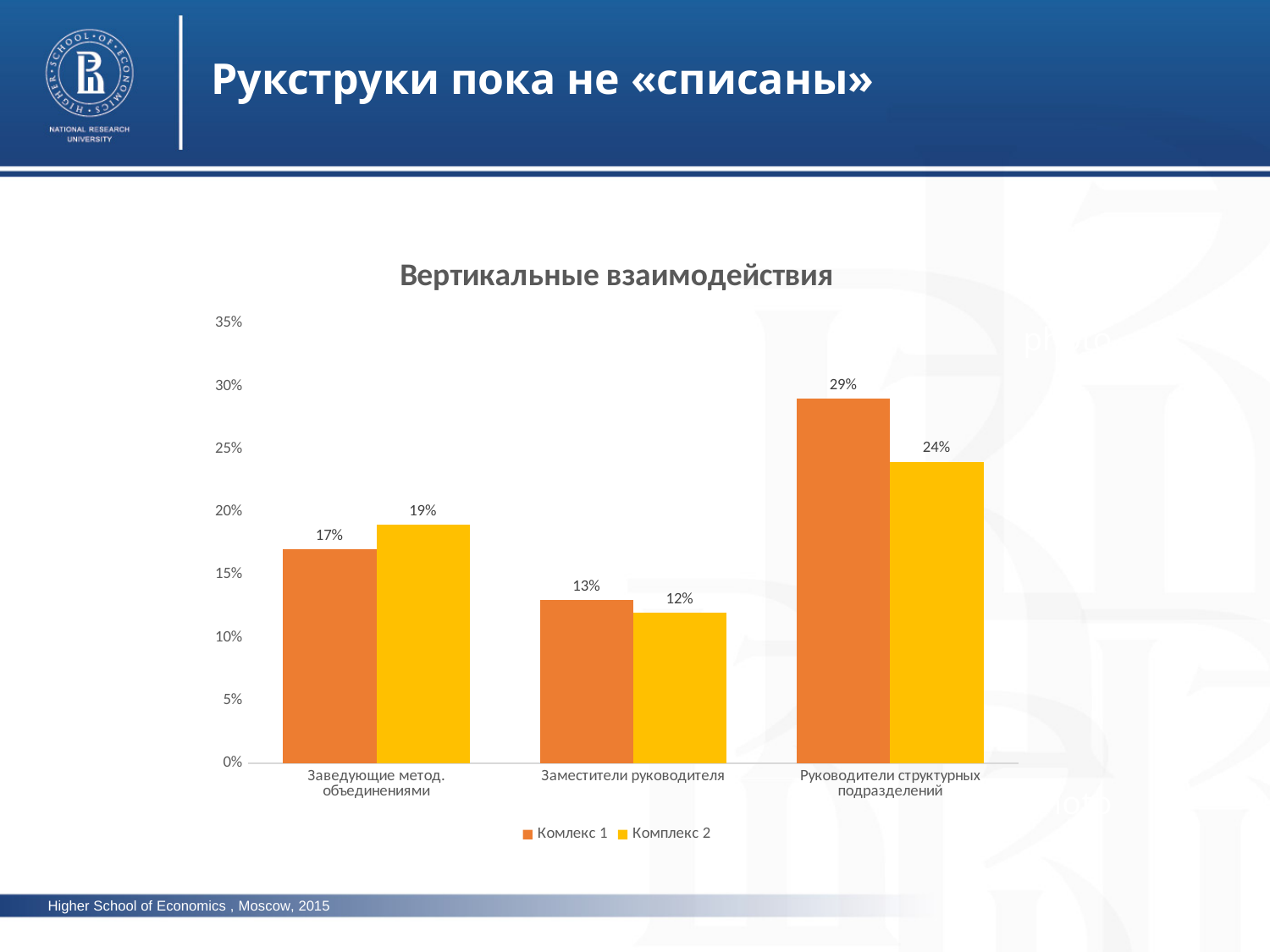
Which category has the highest value for Комлекс 1? Руководители структурных подразделений How many categories are shown on the x axis? 3 What is the value for Комлекс 1 for Заведующие метод. объединениями? 17% How many series does the legend list? 2 Is the value for Комлекс 1 for Руководители структурных подразделений greater or less than 25%? greater What is the value for Комплекс 2 for Заместители руководителя? 12% Which is larger for Заведующие метод. объединениями: Комлекс 1 or Комплекс 2? Комплекс 2 What is the value for Комплекс 2 for Руководители структурных подразделений? 24% What kind of chart is shown? Bar chart Which category has the lowest value for Комплекс 2? Заместители руководителя What is the title of the chart? Вертикальные взаимодействия What is the difference between Комлекс 1 and Комплекс 2 for Руководители структурных подразделений? 5%